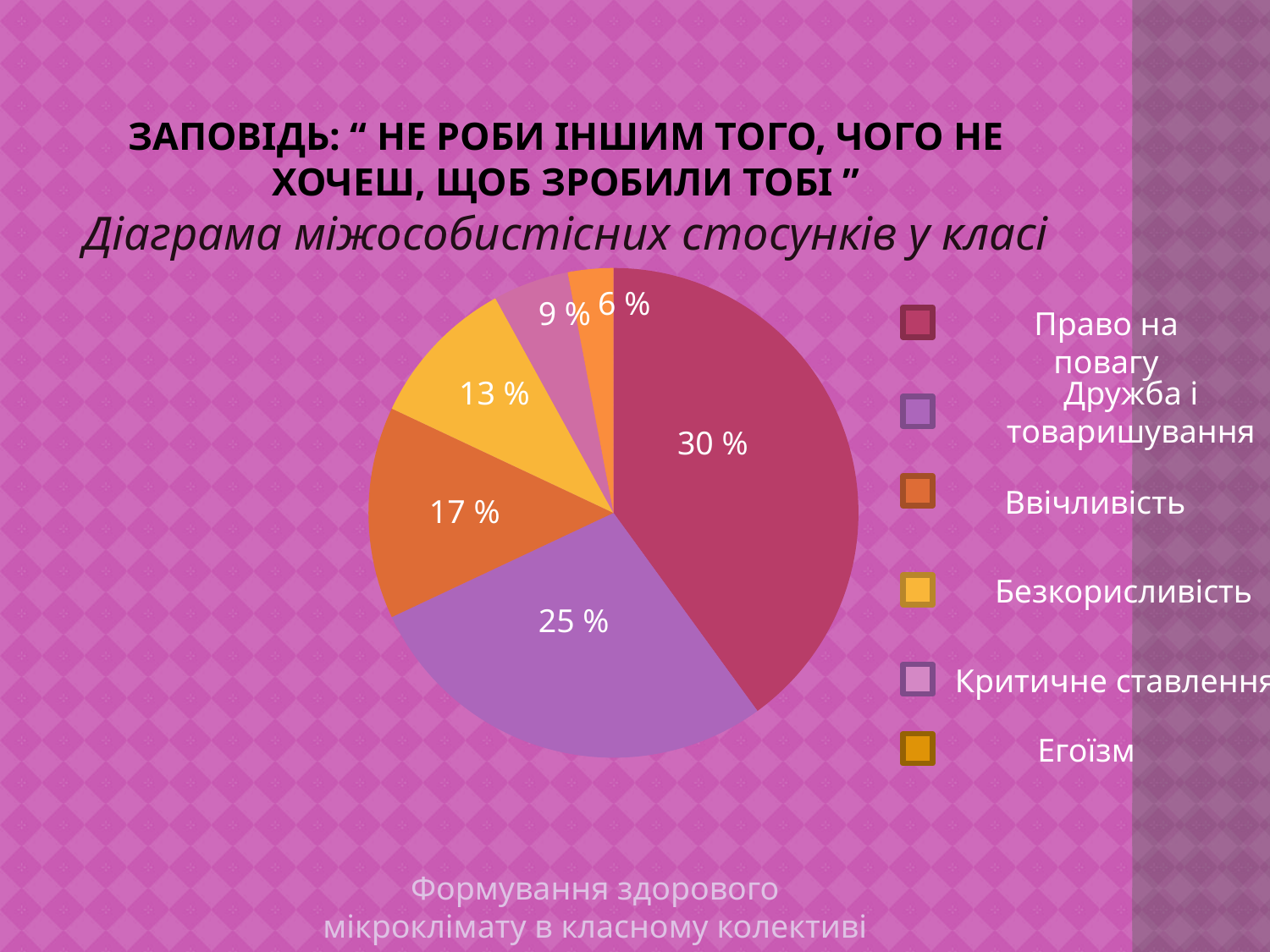
What value is shown for the "Егоїзм" slice? 6 % What is the difference between the "Право на повагу" and "Дружба і товаришування" slices? 5 % What value is shown for the "Ввічливість" slice? 17 % How many slices does the pie chart have? 6 Which is larger, the "Критичне ставлення" slice or the "Безкорисливість" slice? Безкорисливість What kind of chart is shown on the slide? pie chart Which category has the smallest slice of the pie? Егоїзм Which category has the largest slice of the pie? Право на повагу What is the title of the chart? Діаграма міжособистісних стосунків у класі What percentage is shown for "Дружба і товаришування"? 25 % What value is shown for the "Безкорисливість" slice? 13 % What percentage of the pie is labelled for "Право на повагу"? 30 %